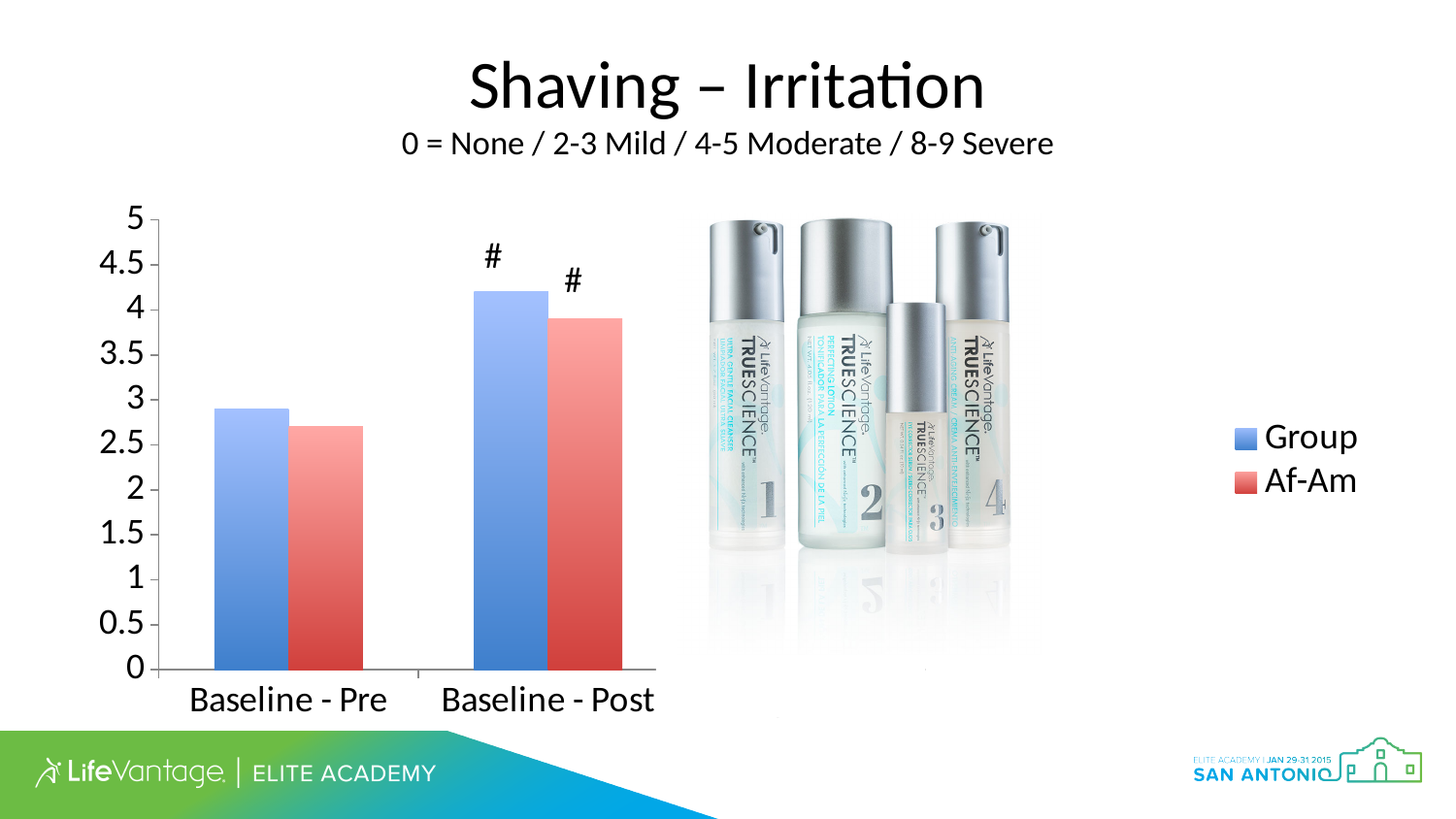
Is the value for Group at Baseline - Post greater or less than 4? greater How many series does the legend list? 2 What kind of chart is shown on the slide? bar chart At Baseline - Post, which series has the larger value, Group or Af-Am? Group Which bar is the lowest in the chart? Af-Am at Baseline - Pre Which bar is the highest in the chart? Group at Baseline - Post What are the two series named in the legend? Group and Af-Am Is the value for Group at Baseline - Pre greater or less than 2.5? greater Do the values for the Group series rise or fall from Baseline - Pre to Baseline - Post? rise At Baseline - Pre, which series has the larger value, Group or Af-Am? Group How many categories are shown on the x axis? 2 Is the value for Af-Am at Baseline - Post greater or less than 3.5? greater